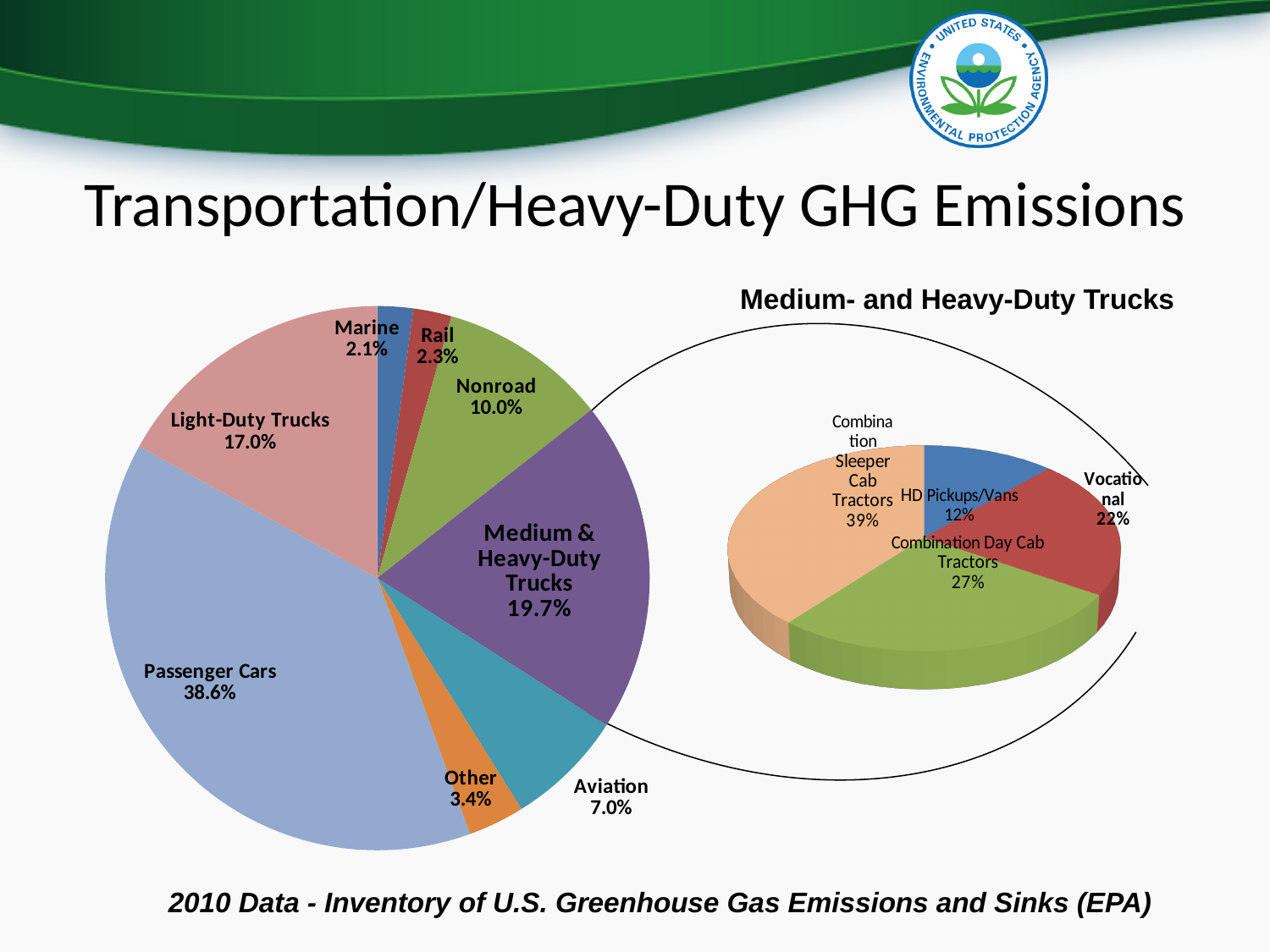
In the large pie chart on the left, which category has the largest share? Passenger Cars In the large pie chart on the left, what is the value shown for Medium & Heavy-Duty Trucks? 19.7% In the large pie chart on the left, which category has the smallest share? Marine How many categories are shown in the large pie chart on the left? 8 In the large pie chart on the left, which is larger, Aviation or Other? Aviation What type of chart is the Medium- and Heavy-Duty Trucks chart on the right? Pie chart In the large pie chart on the left, what share of transportation GHG emissions comes from Passenger Cars? 38.6% In the Medium- and Heavy-Duty Trucks pie chart, what is the difference between the Combination Day Cab Tractors share and the Vocational share? 5% In the Medium- and Heavy-Duty Trucks pie chart, which category has the smallest share? HD Pickups/Vans In the Medium- and Heavy-Duty Trucks pie chart, what share is attributed to Combination Sleeper Cab Tractors? 39% How many categories are shown in the Medium- and Heavy-Duty Trucks pie chart? 4 In the large pie chart on the left, what is the difference between the Light-Duty Trucks share and the Nonroad share? 7.0%